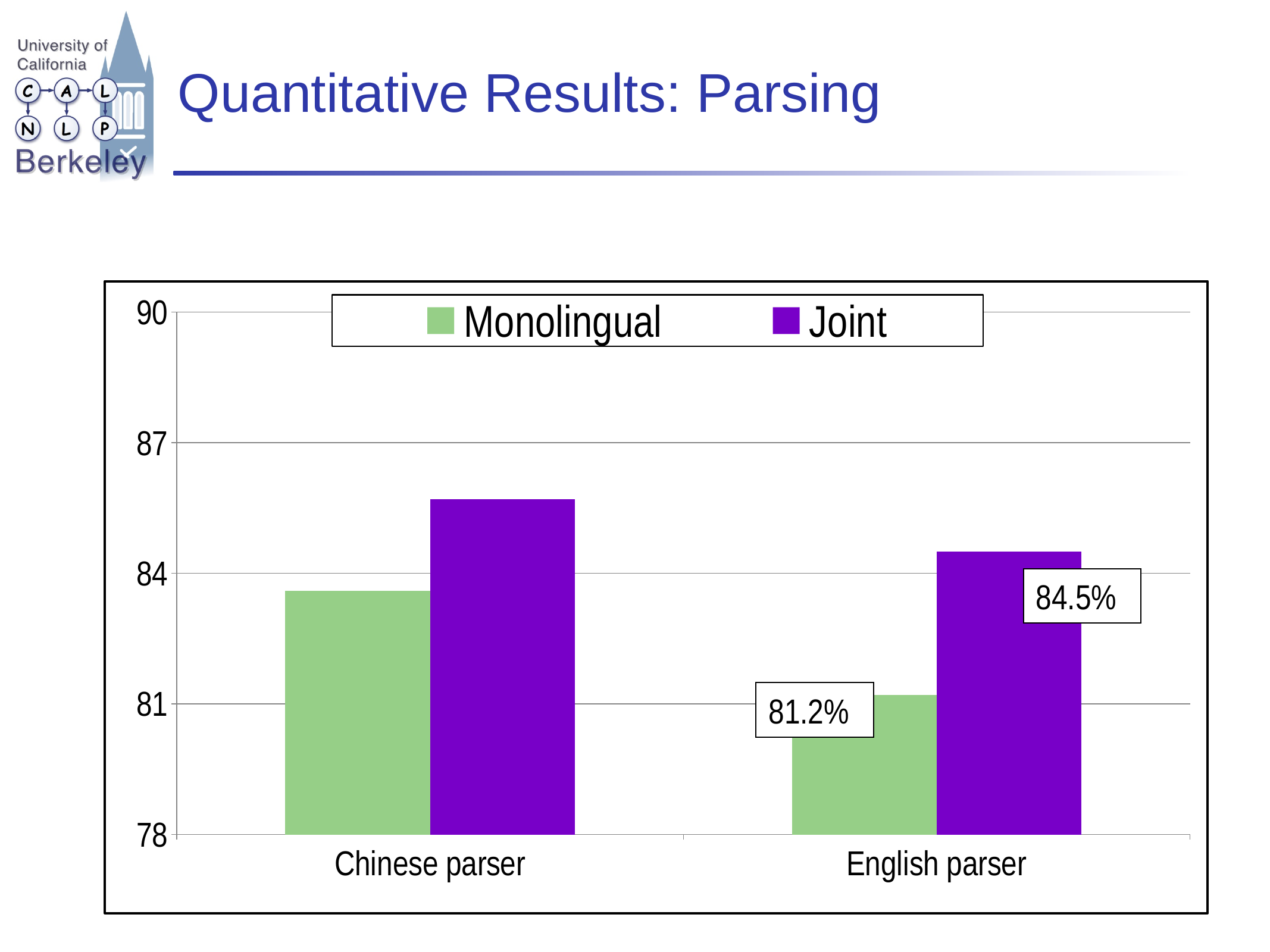
Which bar is the tallest in the chart? Joint for the Chinese parser What is the Joint value for the English parser? 84.5% How many categories are shown on the x axis? 2 How many series does the legend list? 2 Is the Joint value for the Chinese parser greater or less than 84? greater What is the Monolingual value for the English parser? 81.2% Is the Monolingual value for the Chinese parser greater or less than 84? less Is the Joint value for the Chinese parser greater or less than 87? less What colour represents the Joint series in the chart? Purple For the Chinese parser, which is larger: the Monolingual or the Joint value? Joint What is the difference between the Joint and Monolingual values for the English parser? 3.3% What type of chart is shown on the slide? Bar chart